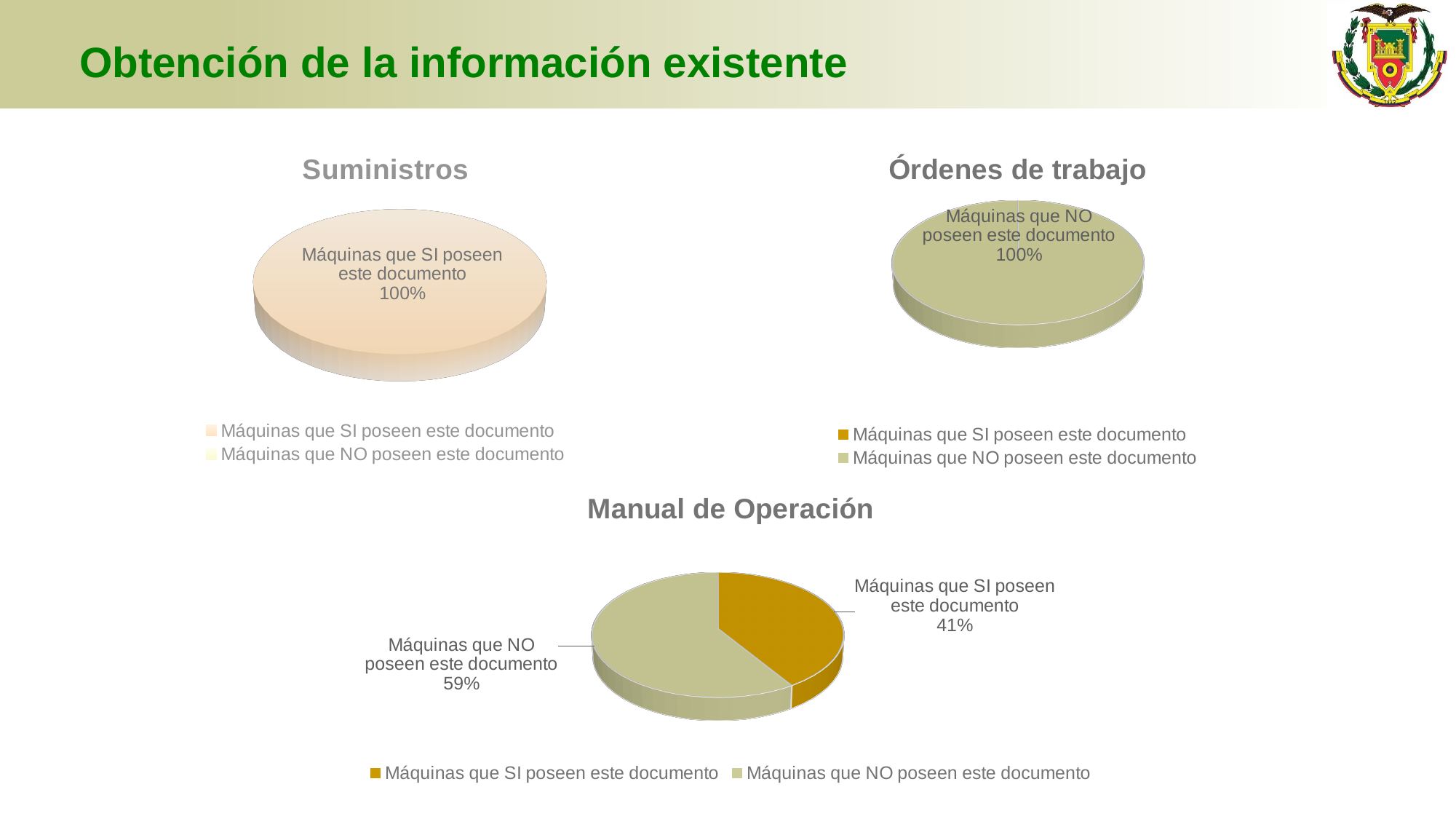
In the 'Manual de Operación' chart, which category has the smallest share? Máquinas que SI poseen este documento What kind of chart is 'Suministros'? Pie chart In the 'Manual de Operación' chart, what colour is the slice for machines that have the document (SI)? Dark gold In the 'Suministros' chart, what share of machines have this document (Máquinas que SI poseen este documento)? 100% In the 'Manual de Operación' chart, what is the difference in percentage points between the NO slice and the SI slice? 18 In the 'Manual de Operación' chart, which slice is larger: machines that have the document or machines that do not? Máquinas que NO poseen este documento How many entries does the legend of the 'Órdenes de trabajo' chart list? 2 In the 'Órdenes de trabajo' chart, what share of machines do NOT have this document? 100% How many charts are shown on the slide? 3 In the 'Manual de Operación' chart, what share of machines have this document (Máquinas que SI poseen este documento)? 41% What is the title of the chart at the bottom of the slide? Manual de Operación